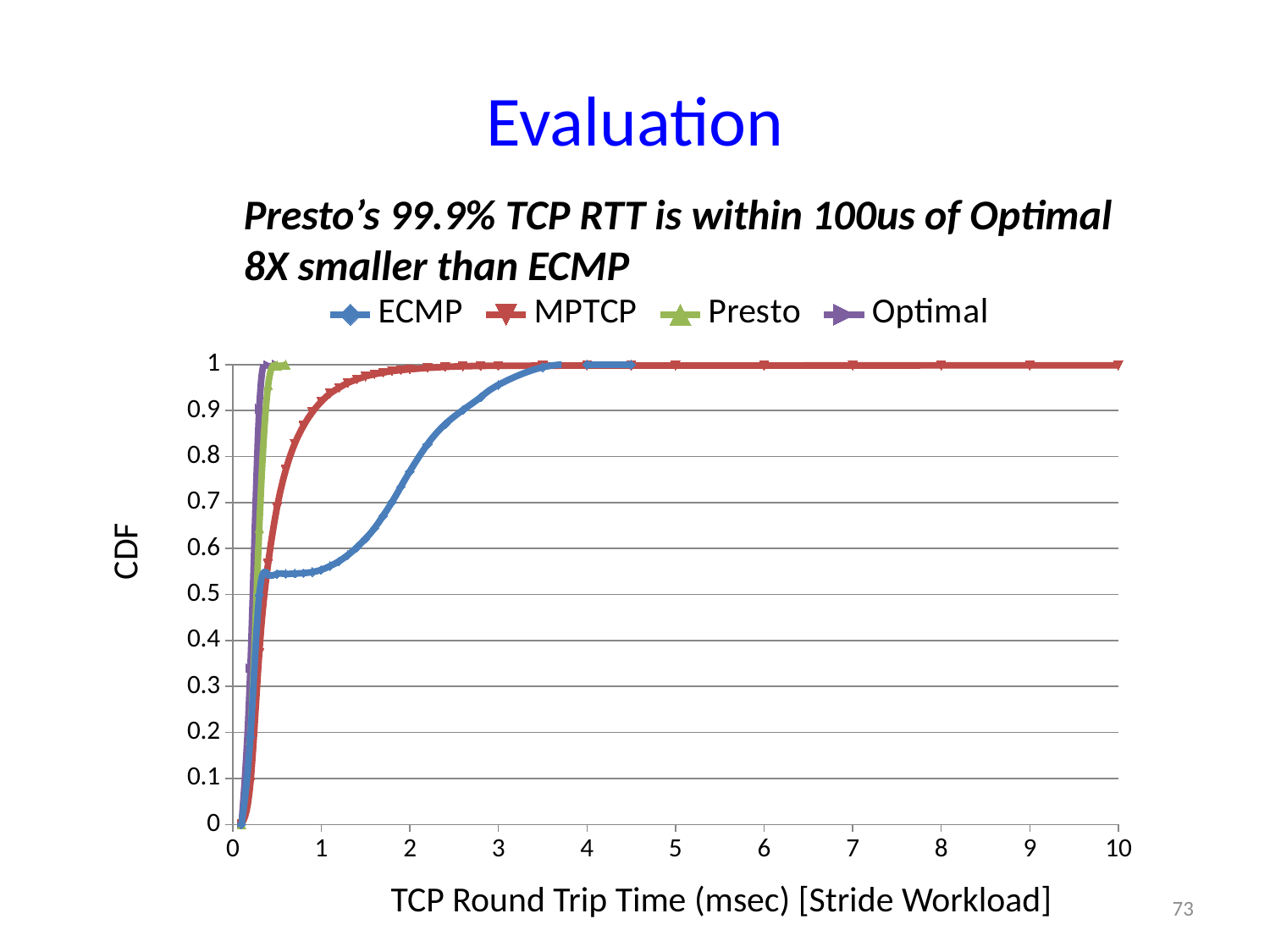
Is the CDF value for ECMP at 3 msec greater or less than 0.9? greater Which series is the last to reach a CDF of 1 along the x axis? ECMP Is the CDF value for MPTCP at 2 msec greater or less than 0.9? greater How many series does the legend list? 4 What is the label of the y axis? CDF Which series has the lowest CDF at 2 msec? ECMP What kind of chart is shown on the slide? line chart Do the CDF curves rise or fall as TCP round trip time increases? rise What is the label of the x axis? TCP Round Trip Time (msec) [Stride Workload] Is the CDF value for ECMP at 2 msec greater or less than 0.9? less At 1 msec, which series has the larger CDF, ECMP or MPTCP? MPTCP